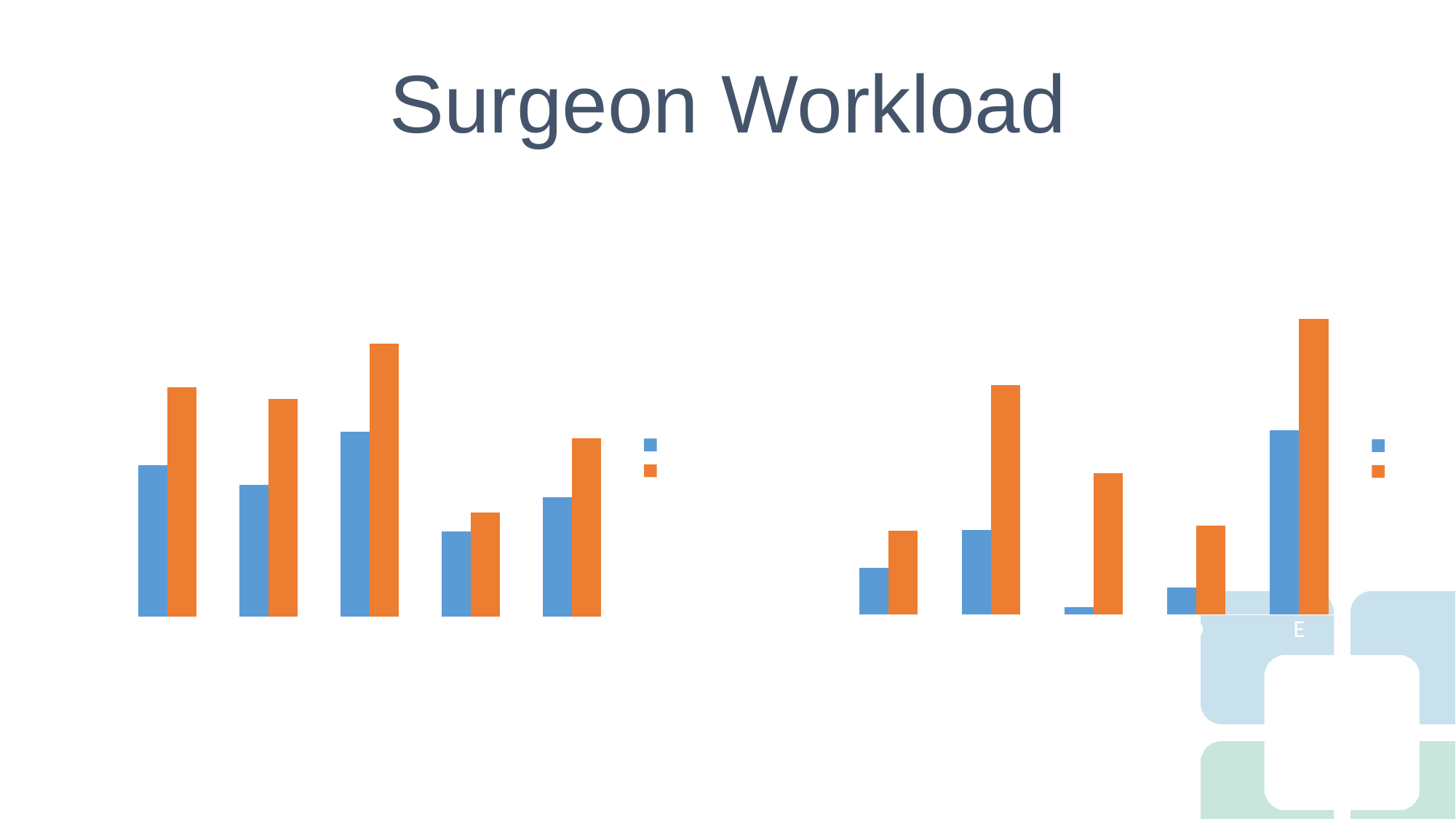
What two colours are used for the bar series in the charts? blue and orange How many series does the legend of the right chart list? 2 What is the title of the slide? Surgeon Workload In the left chart, is the orange bar taller or shorter than the blue bar in every group? taller How many series does the legend of the left chart list? 2 In the right chart, which group of bars, counting from the left, has the tallest orange bar? the fifth In the right chart, which group of bars, counting from the left, has the shortest blue bar? the third How many groups of bars are plotted in the right chart? 5 What kind of chart is the chart on the right side of the slide? bar chart What kind of chart is the chart on the left side of the slide? bar chart In the left chart, which group of bars, counting from the left, has the tallest orange bar? the third How many groups of bars are plotted in the left chart? 5